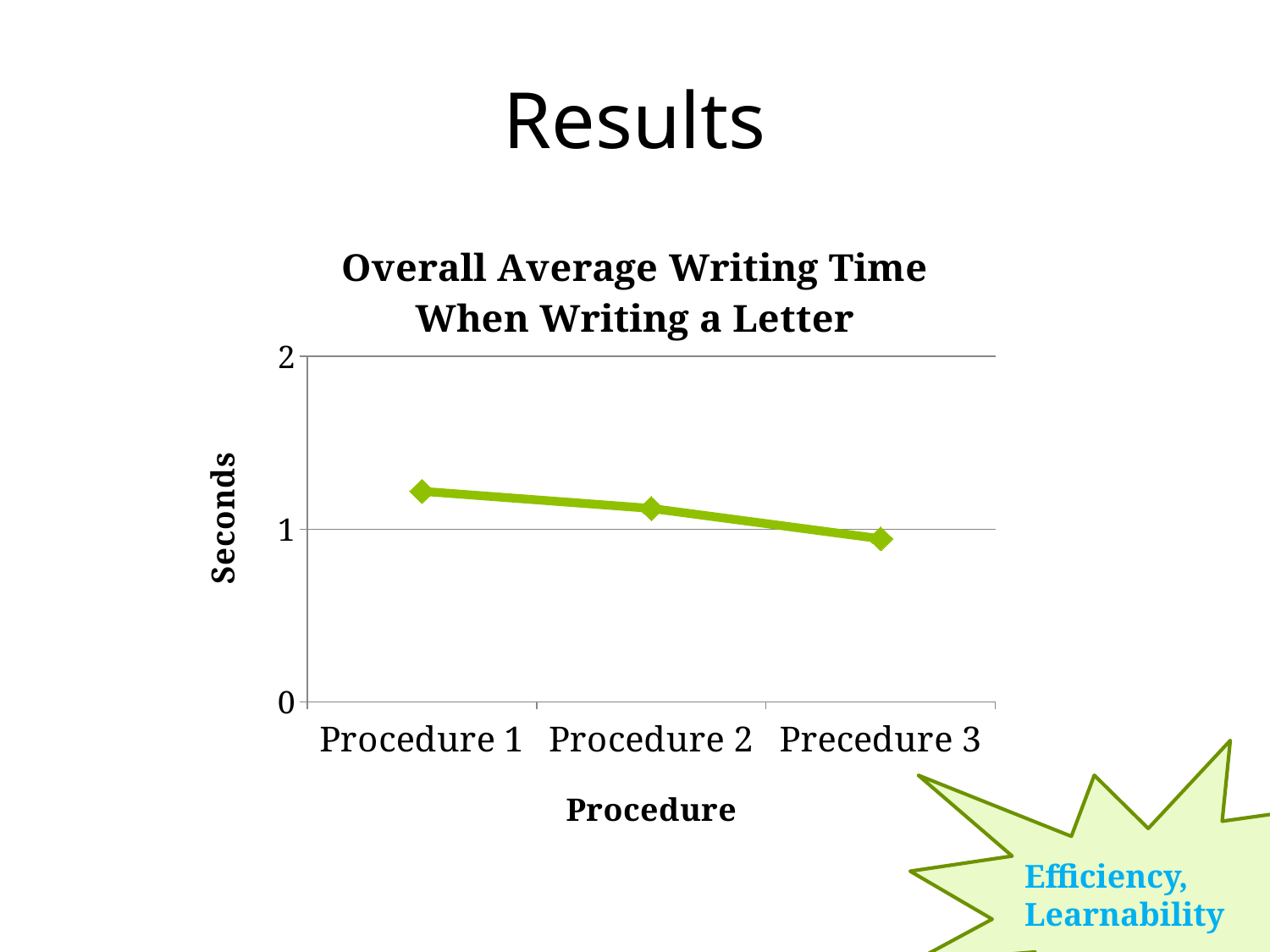
Is the value for Procedure 1 greater or less than 1? greater Which procedure has the highest average writing time? Procedure 1 Is the value for Procedure 2 greater or less than 2? less Do the values rise or fall from Procedure 1 to Precedure 3? fall What is the label on the y axis of the chart? Seconds What kind of chart is shown on the slide? line chart How many procedures are plotted on the x axis of the chart? 3 What is the title of the chart? Overall Average Writing Time When Writing a Letter Which has a larger average writing time, Procedure 1 or Precedure 3? Procedure 1 Which has a larger average writing time, Procedure 2 or Precedure 3? Procedure 2 Which procedure has the lowest average writing time? Precedure 3